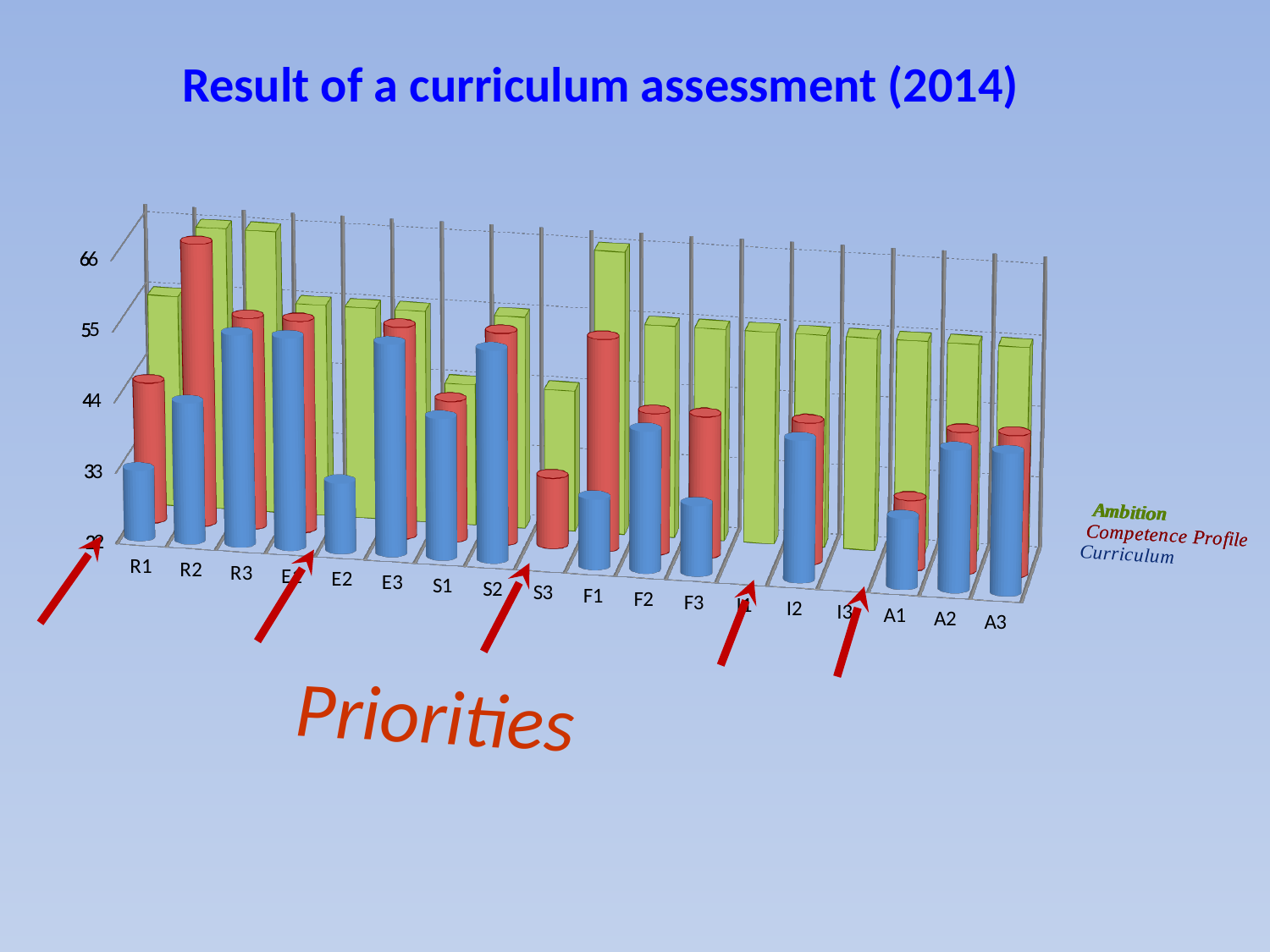
Which category has the highest Competence Profile value? R2 Is the Curriculum value for S3 greater or less than 44? less Is the Competence Profile value for R2 greater or less than 55? greater Is the Curriculum value for A1 greater or less than 44? less How many series does the legend list? 3 What kind of chart is shown on the slide? bar chart Which is larger, the Competence Profile value for R2 or the Competence Profile value for A1? R2 How many categories are shown along the x axis? 18 What is the title of the chart? Result of a curriculum assessment (2014) Which series is shown in green? Ambition Which is larger, the Curriculum value for R3 or the Curriculum value for S3? R3